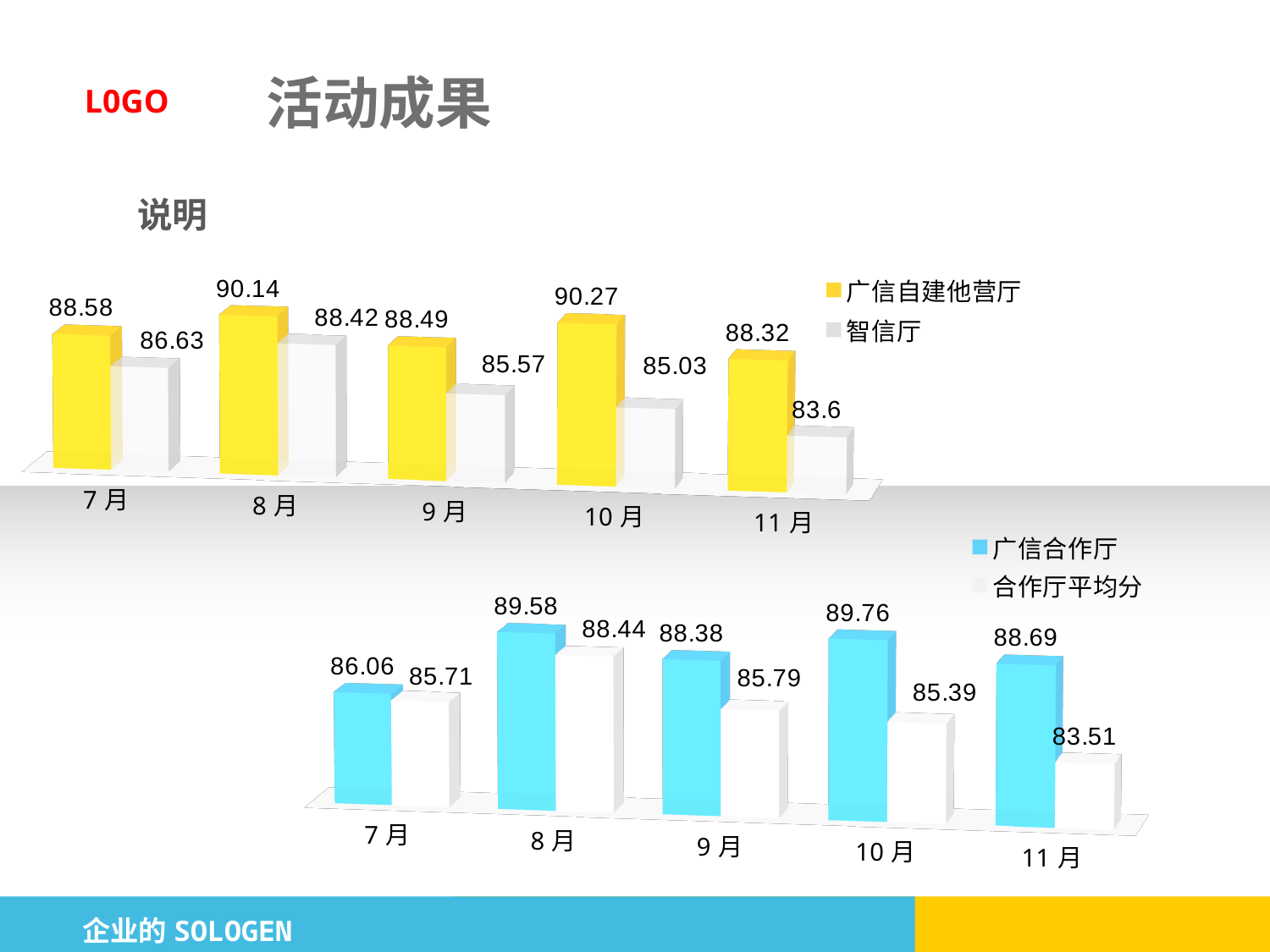
In the upper chart, what is the value for 广信自建他营厅 in 8月? 90.14 In the lower chart, which is larger in 8月: 广信合作厅 or 合作厅平均分? 广信合作厅 In the lower chart, what is the value for 广信合作厅 in 10月? 89.76 In the upper chart, which month has the highest value for 广信自建他营厅? 10月 In the upper chart, what is the value for 智信厅 in 11月? 83.6 In the upper chart, which month has the lowest value for 智信厅? 11月 In the lower chart, which month has the lowest value for 广信合作厅? 7月 In the upper chart, what is the difference between 广信自建他营厅 and 智信厅 in 10月? 5.24 In the lower chart, how many months are shown on the x axis? 5 In the lower chart, what is the value for 合作厅平均分 in 9月? 85.79 What kind of chart is the lower chart? Bar chart In the upper chart, how many series does the legend list? 2